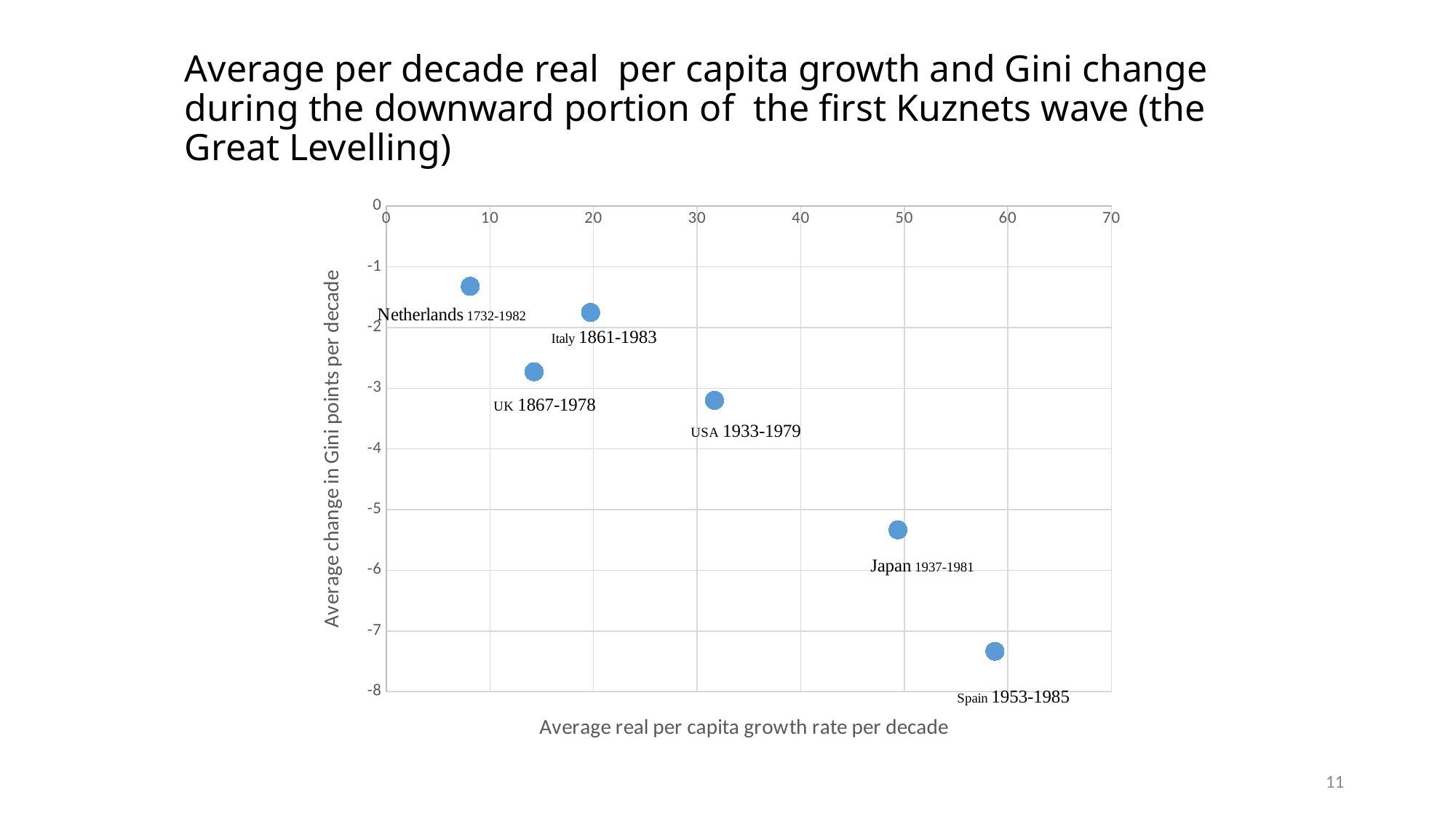
Is the average change in Gini points per decade for Spain greater or less than -7? less What kind of chart is shown on the slide? scatter chart Is the average real per capita growth rate per decade for Japan greater or less than 40? greater Which country has the smallest average change in Gini points per decade (closest to zero)? Netherlands Which country has the largest (most negative) average change in Gini points per decade? Spain How many countries are plotted on the chart? 6 Is the average real per capita growth rate per decade for the USA greater or less than 30? greater What is the title of the x axis? Average real per capita growth rate per decade Which country has the lowest average real per capita growth rate per decade? Netherlands Which country has the highest average real per capita growth rate per decade? Spain Which has a higher average real per capita growth rate per decade, Italy or the UK? Italy As the average real per capita growth rate increases along the x axis, does the average change in Gini points generally rise or fall? fall